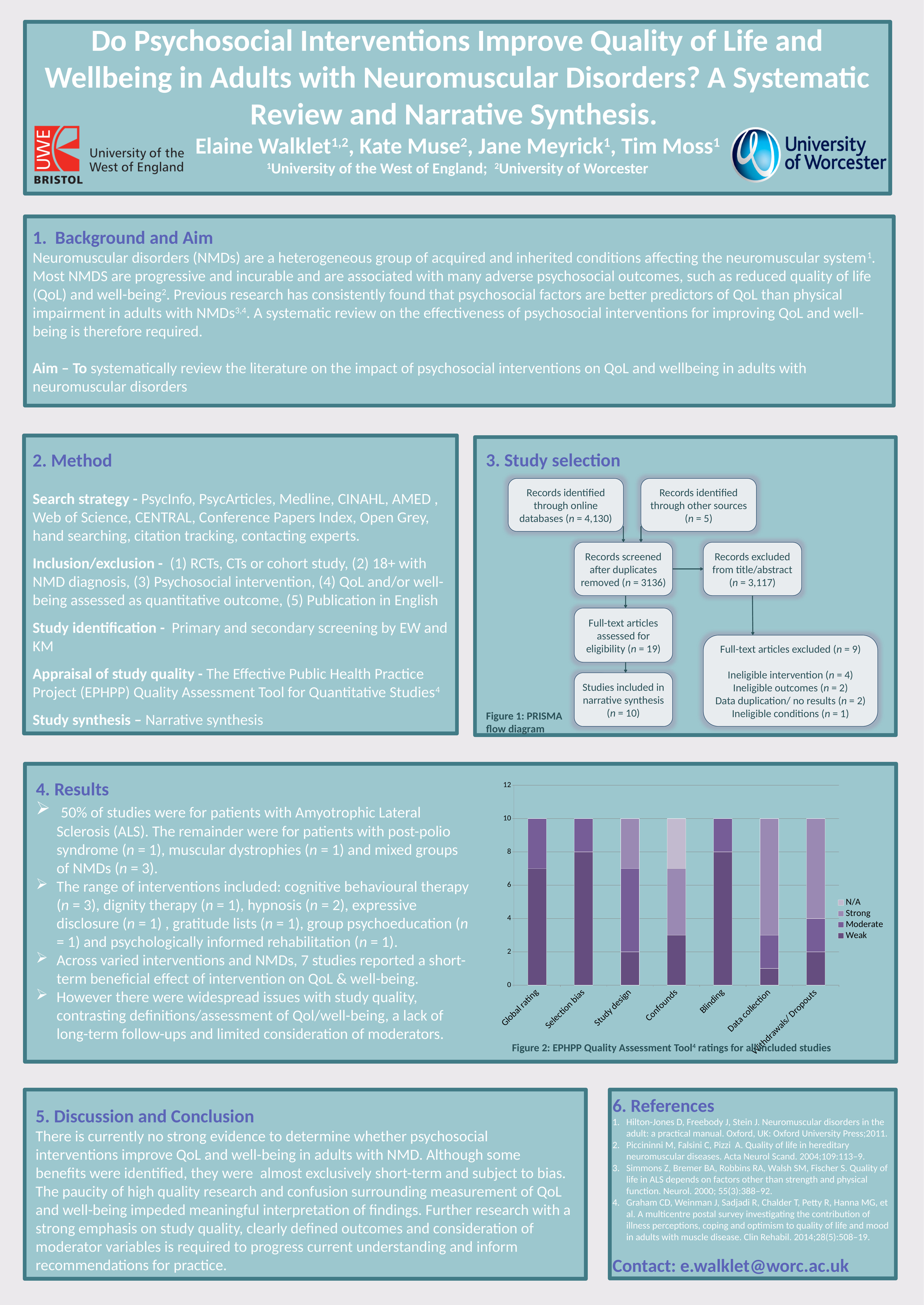
In Figure 2, is the Weak value for Blinding greater or less than 6? greater In Figure 2, what is the total height of the stacked bar for Withdrawals/ Dropouts? 10 In Figure 2, which category has the larger Strong segment, Data collection or Study design? Data collection In Figure 2, what is the total height of the stacked bar for Global rating? 10 In Figure 2, which category has the larger Weak segment, Selection bias or Data collection? Selection bias In Figure 2, which is the only category with an N/A segment? Confounds In Figure 2, is the Weak value for Selection bias greater or less than 6? greater What are the four legend entries in Figure 2? N/A, Strong, Moderate, Weak How many series does the legend of Figure 2 list? 4 How many categories are shown on the x axis of Figure 2? 7 In Figure 2, is the Weak value for Data collection greater or less than 2? less What kind of chart is Figure 2 on the slide? stacked bar chart